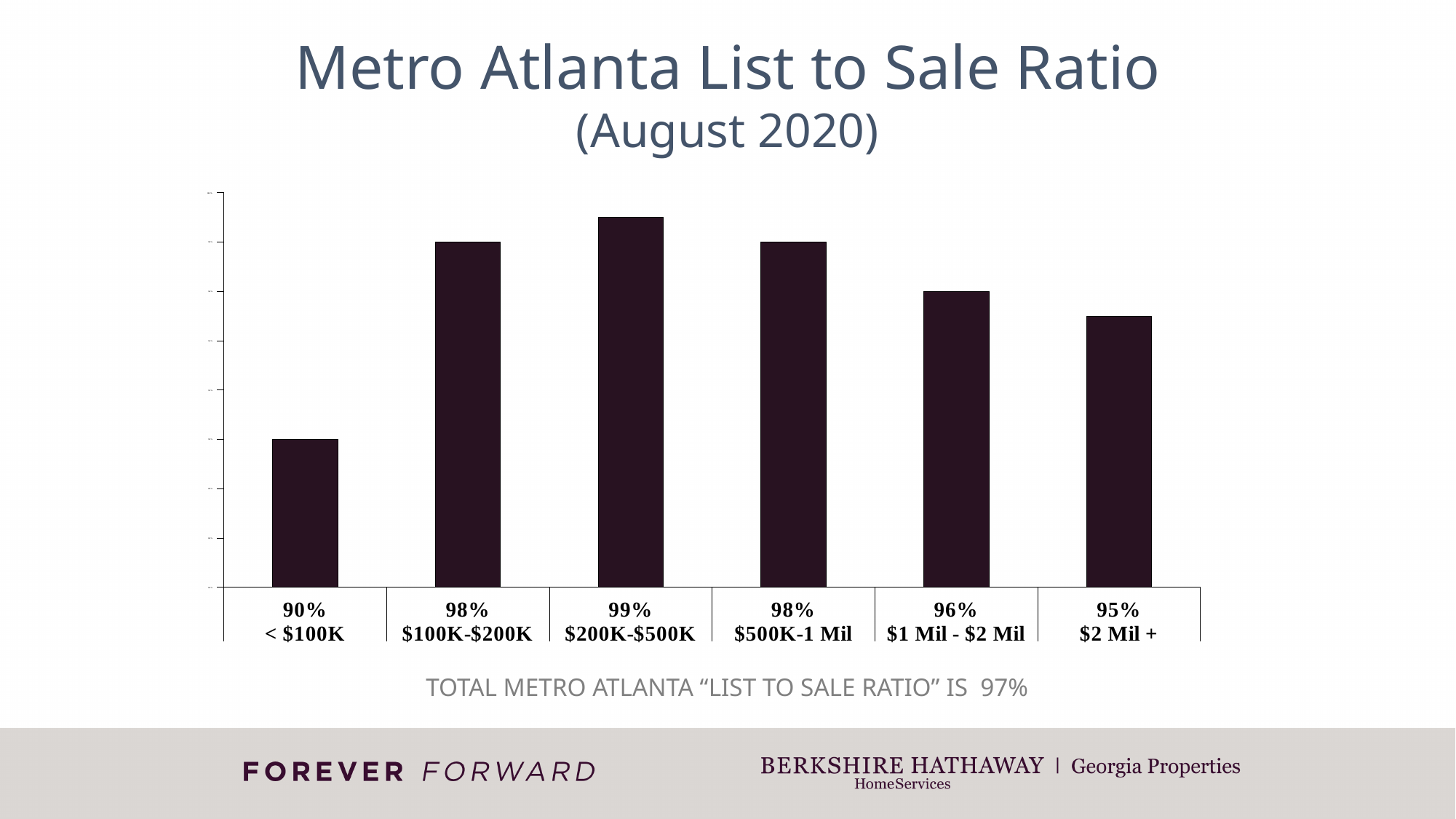
What is the list to sale ratio for the $2 Mil + price range? 95% What is the list to sale ratio for the < $100K price range? 90% What is the total Metro Atlanta list to sale ratio stated on the slide? 97% What is the list to sale ratio for the $200K-$500K price range? 99% How many price ranges are shown in the chart? 6 What is the difference in list to sale ratio between the $200K-$500K and < $100K price ranges? 9 percentage points What month and year does the chart cover? August 2020 Which price range has the highest list to sale ratio? $200K-$500K What is the list to sale ratio for the $1 Mil - $2 Mil price range? 96% Which price range has the lowest list to sale ratio? < $100K Which has a higher list to sale ratio, $1 Mil - $2 Mil or $2 Mil +? $1 Mil - $2 Mil What type of chart is shown on the slide? Bar chart